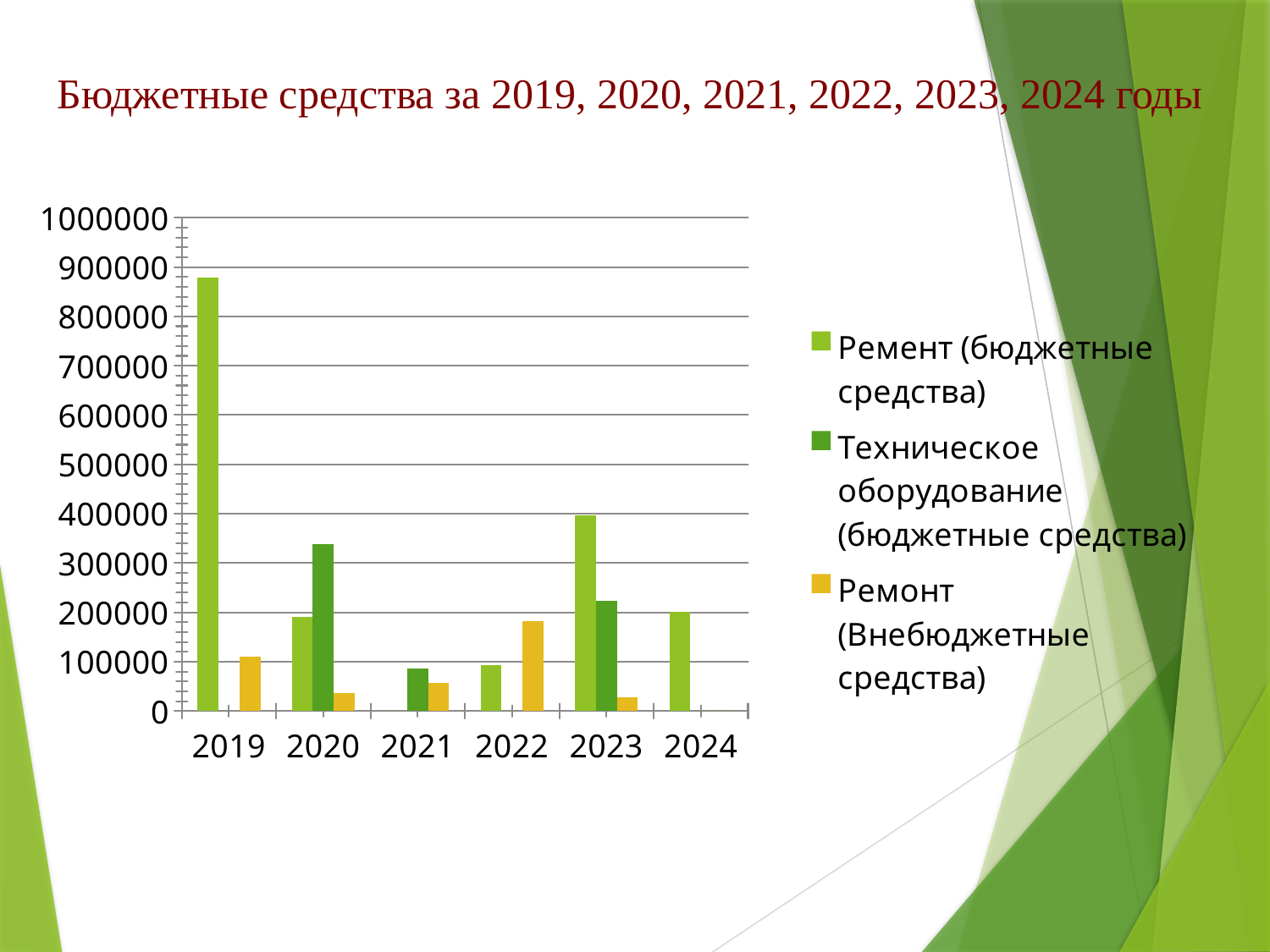
Is the value for Ремент (бюджетные средства) in 2019 greater or less than 800000? greater How many years are shown on the x axis? 6 How many series does the legend list? 3 Which year has the highest value for Техническое оборудование (бюджетные средства)? 2020 What colour represents Ремонт (Внебюджетные средства) in the legend? yellow In 2023, which is larger: Ремент (бюджетные средства) or Техническое оборудование (бюджетные средства)? Ремент (бюджетные средства) What kind of chart is shown on the slide? bar chart In 2022, which is larger: Ремент (бюджетные средства) or Ремонт (Внебюджетные средства)? Ремонт (Внебюджетные средства) Is the value for Ремент (бюджетные средства) in 2024 greater or less than 300000? less In 2021, which is larger: Техническое оборудование (бюджетные средства) or Ремонт (Внебюджетные средства)? Техническое оборудование (бюджетные средства) Which year has the highest value for Ремент (бюджетные средства)? 2019 Is the value for Техническое оборудование (бюджетные средства) in 2020 greater or less than 300000? greater